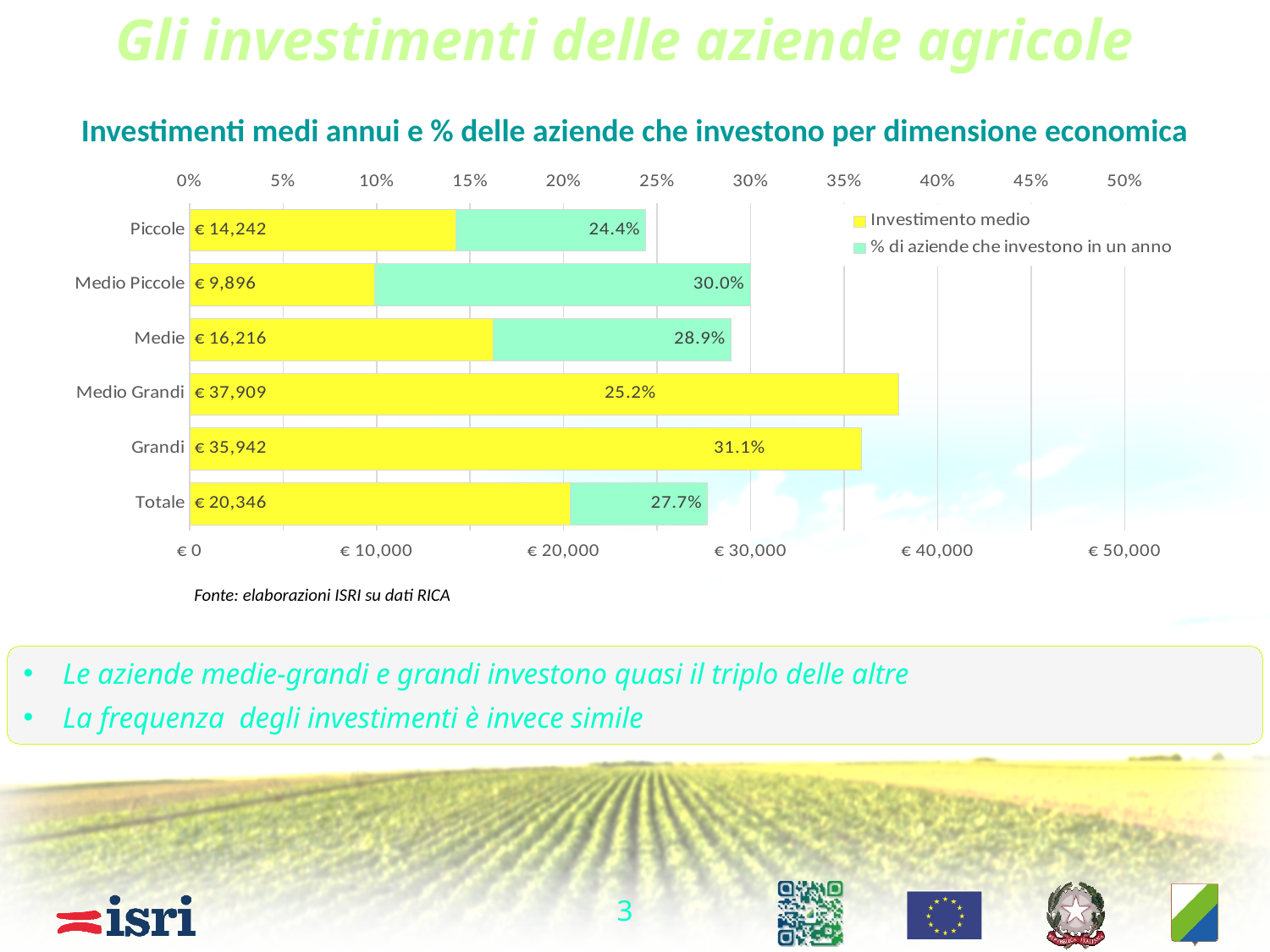
Which has a larger Investimento medio, Medie or Piccole? Medie What percentage of Medio Piccole farms invest in a year, according to the chart? 30.0% How many series does the legend list? 2 What is the Investimento medio value for the Totale category? € 20,346 What is the difference in Investimento medio between Medio Grandi and Grandi farms? € 1,967 Which category has the highest percentage of farms investing in a year? Grandi Which category has the lowest percentage of farms investing in a year? Piccole What is the average annual investment (Investimento medio) for Medio Grandi farms? € 37,909 Which category has the lowest Investimento medio? Medio Piccole How many categories are shown on the chart? 6 Which category has the highest Investimento medio? Medio Grandi What type of chart is shown on the slide? Bar chart